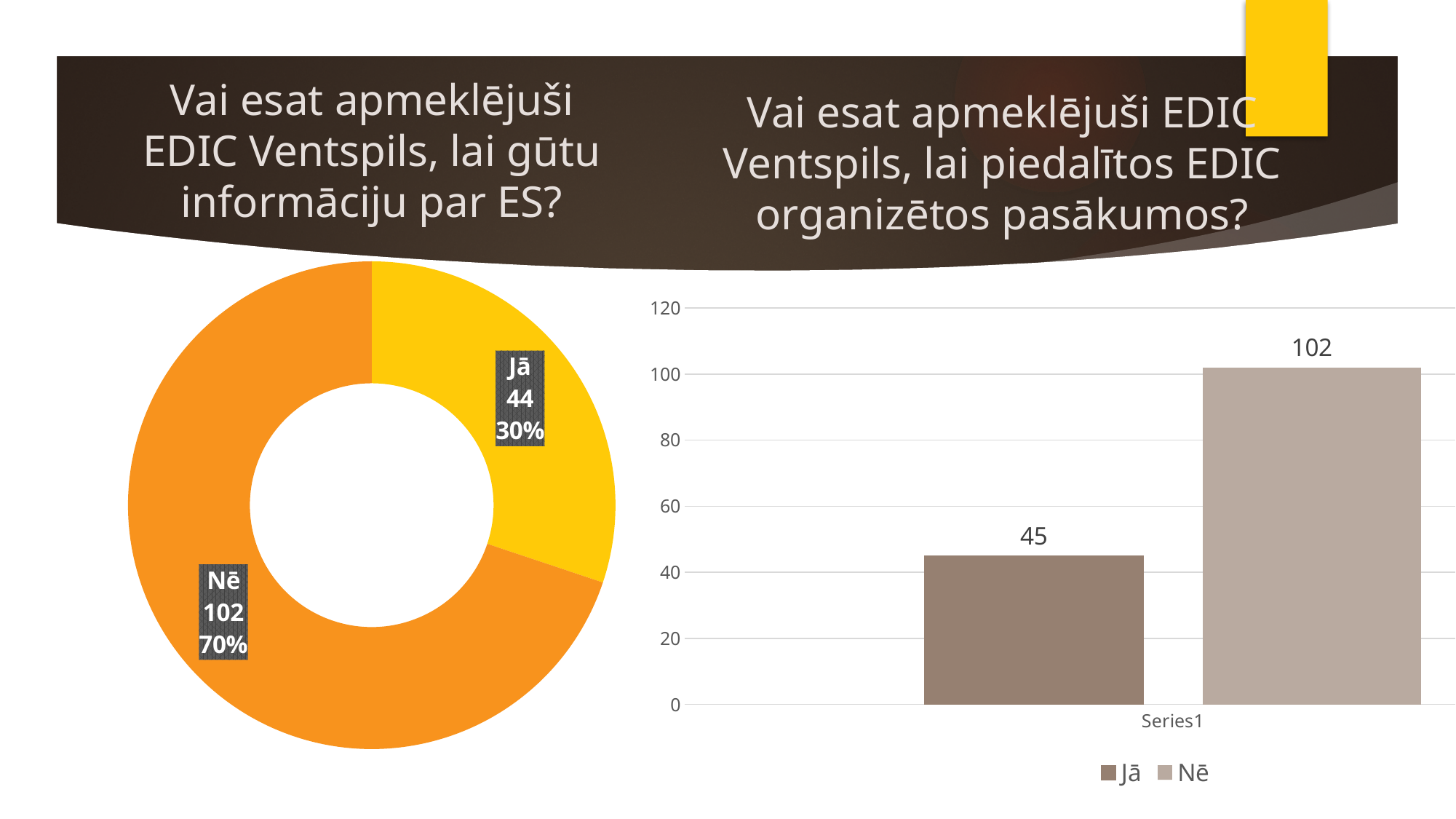
In the left chart, what share of the doughnut does Jā represent? 30% In the right chart, what is the value for Nē? 102 In the left chart, which category has the larger value, Jā or Nē? Nē In the right chart, what is the difference between the values for Nē and Jā? 57 In the left chart, what percentage is shown for Nē? 70% What kind of chart is the right chart? Bar chart How many series does the legend of the right chart list? 2 In the left chart, what value is shown for Jā? 44 In the right chart, what is the value for Jā? 45 In the right chart, which series has the highest value? Nē What is the category label shown on the x axis of the right chart? Series1 What kind of chart is the left chart? Doughnut chart